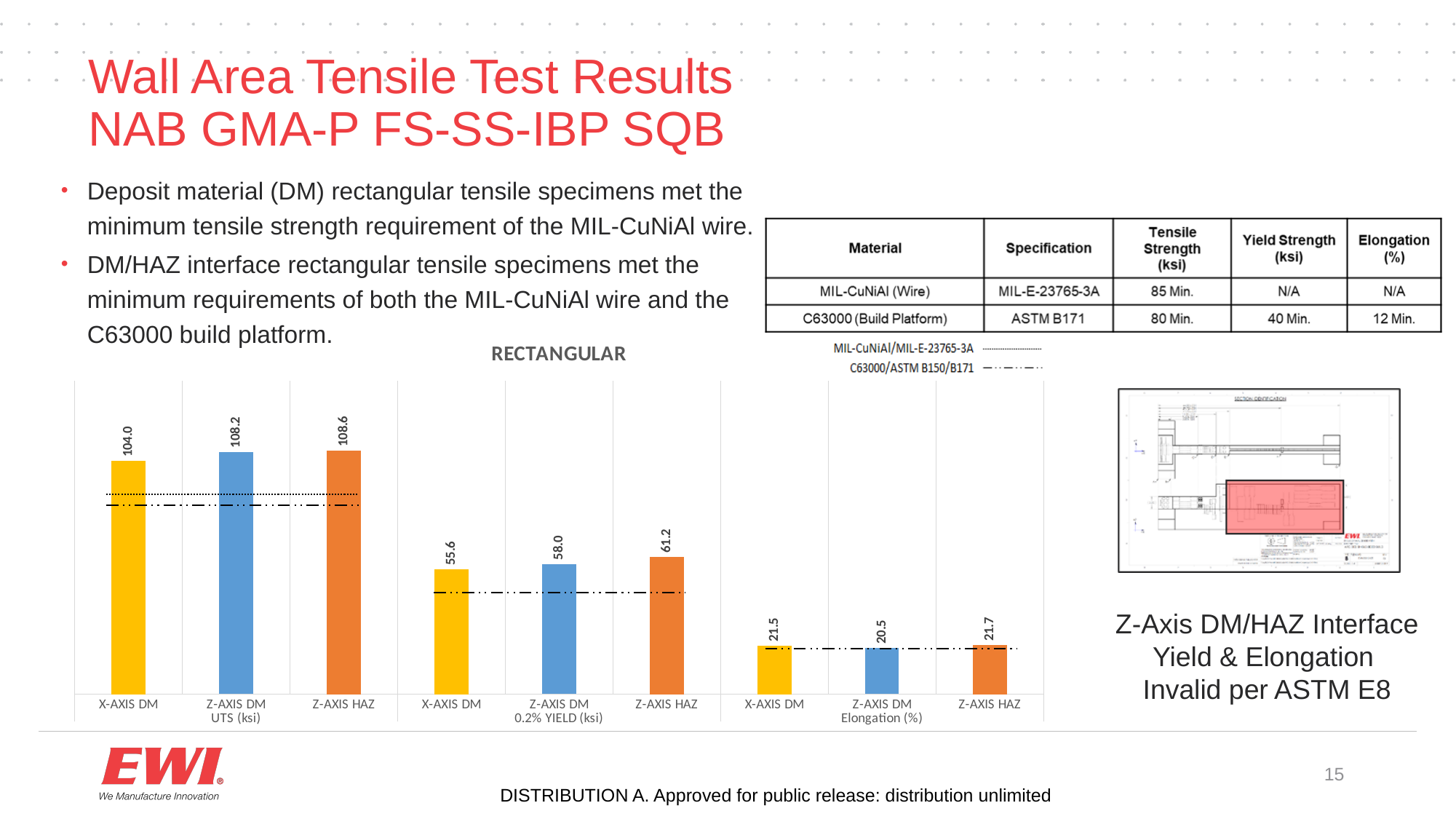
What is the difference in UTS (ksi) between the Z-AXIS HAZ and X-AXIS DM specimens? 4.6 Which has the larger 0.2% YIELD (ksi): X-AXIS DM or Z-AXIS DM? Z-AXIS DM Which specimen has the highest 0.2% YIELD (ksi)? Z-AXIS HAZ How many bars are plotted in the RECTANGULAR chart? 9 Which specimen has the lowest Elongation (%)? Z-AXIS DM What is the difference in 0.2% YIELD (ksi) between the Z-AXIS HAZ and X-AXIS DM specimens? 5.6 What is the 0.2% YIELD (ksi) value for the Z-AXIS HAZ specimen? 61.2 What type of chart is the RECTANGULAR chart? Bar chart What is the Elongation (%) value for the Z-AXIS DM specimen? 20.5 What is the UTS (ksi) value for the Z-AXIS DM specimen? 108.2 What is the UTS (ksi) value for the X-AXIS DM specimen in the RECTANGULAR chart? 104.0 Which specimen has the lowest UTS (ksi) in the RECTANGULAR chart? X-AXIS DM